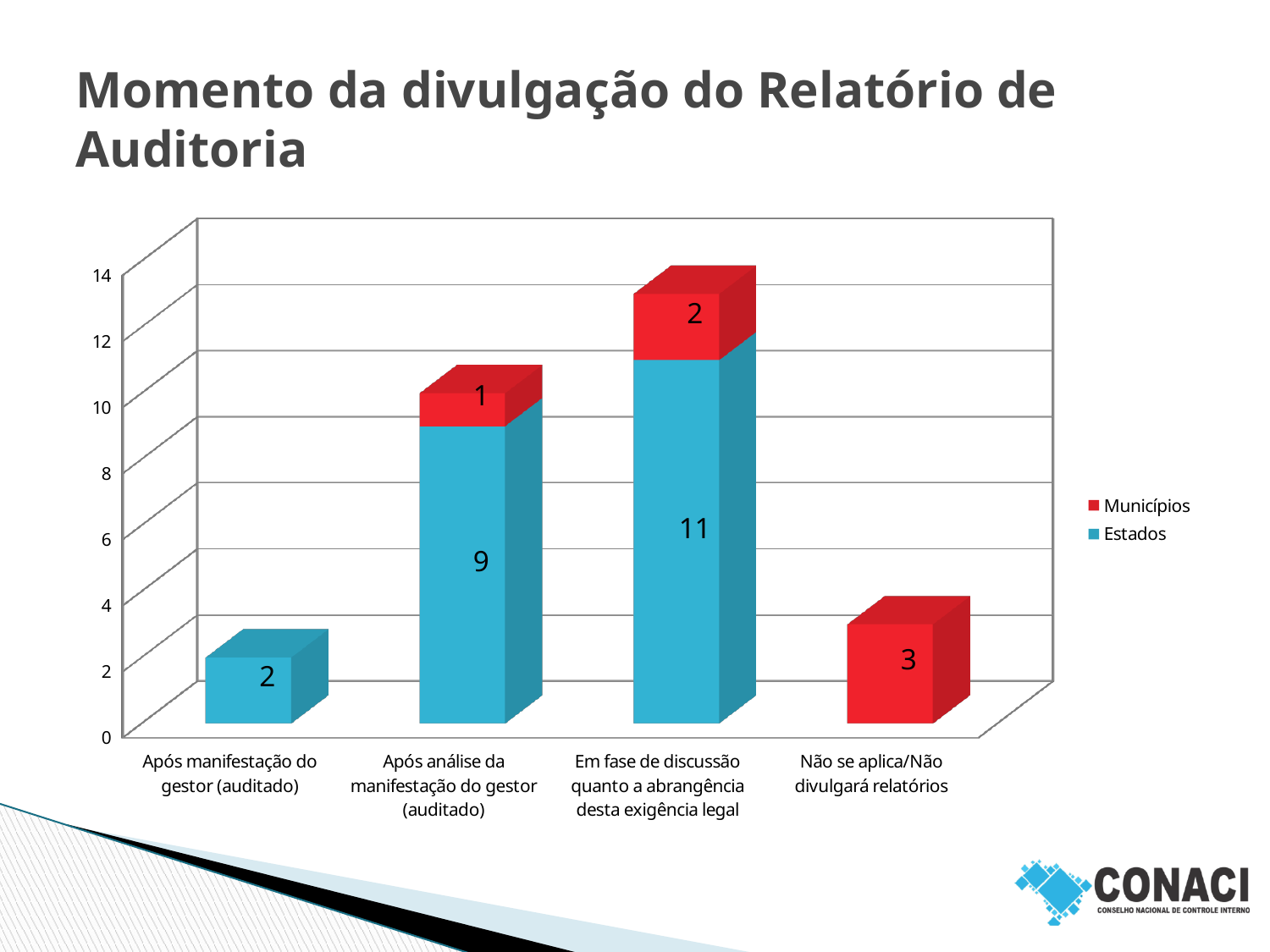
What is the value for Municípios in the category 'Não se aplica/Não divulgará relatórios'? 3 What is the value for Municípios in the category 'Após análise da manifestação do gestor (auditado)'? 1 How many categories are shown on the x axis? 4 How many series does the legend list? 2 What kind of chart is shown on the slide? stacked bar chart Which colour represents the Municípios series in the legend? red What is the value for Estados in the category 'Em fase de discussão quanto a abrangência desta exigência legal'? 11 Which category has the highest value for Estados? Em fase de discussão quanto a abrangência desta exigência legal Which category has the highest value for Municípios? Não se aplica/Não divulgará relatórios What is the total of the stacked bar for 'Em fase de discussão quanto a abrangência desta exigência legal'? 13 What is the difference between the Estados values for 'Em fase de discussão quanto a abrangência desta exigência legal' and 'Após análise da manifestação do gestor (auditado)'? 2 What is the value for Estados in the category 'Após manifestação do gestor (auditado)'? 2